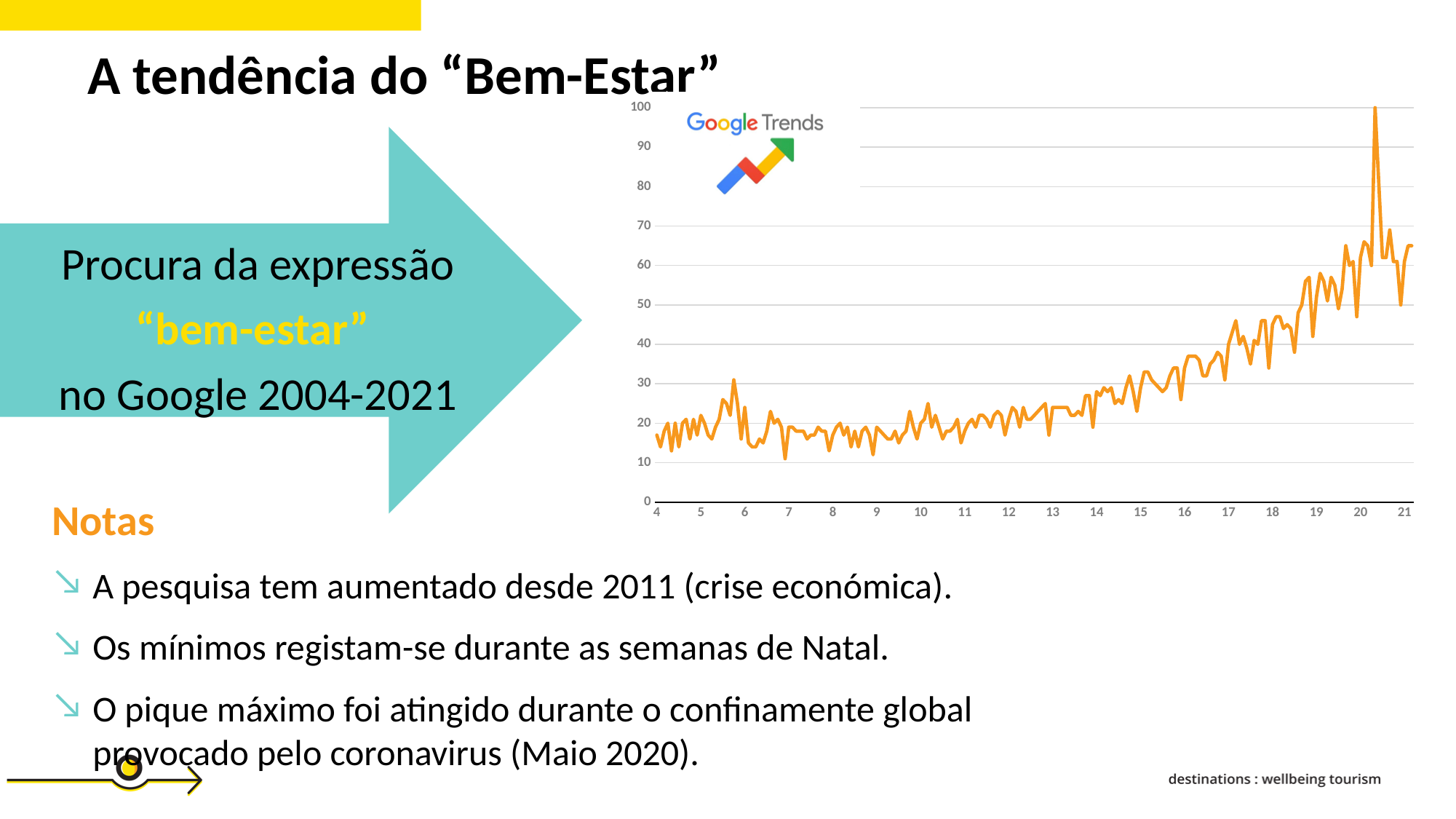
Overall, do the values in the chart rise or fall from 2004 to 2021? rise In which year does the line reach its highest peak? 2020 Is the highest peak of the line greater or less than 90? greater Are the values around year 19 (2019) greater or less than 40? greater Are the values around year 21 (2021) greater or less than 40? greater What is the maximum value shown on the y axis? 100 What colour is the line in the chart? orange How many lines (series) are plotted in the chart? 1 What kind of chart is shown on the slide? line chart How many year labels are shown on the x axis? 18